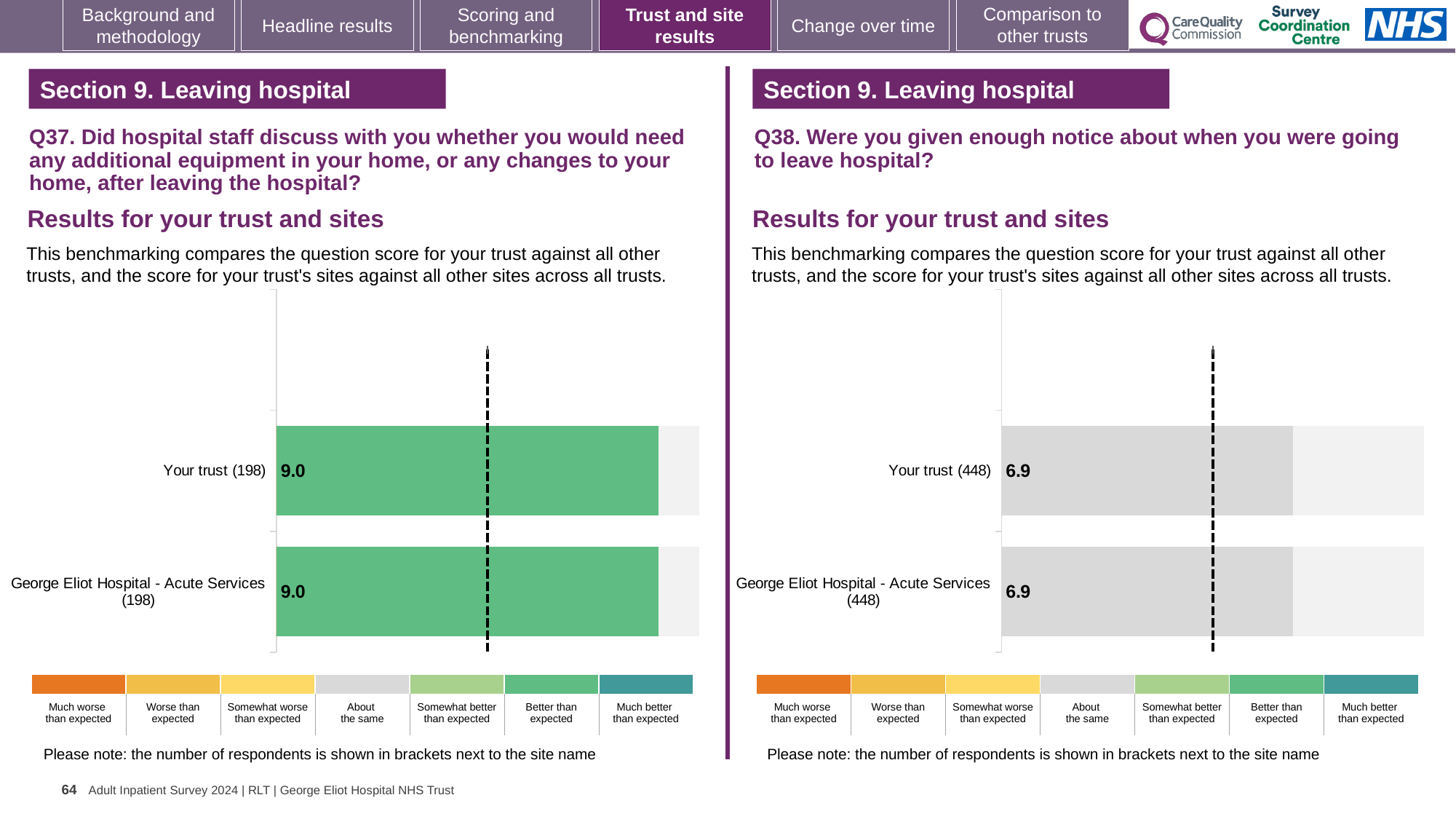
In the Q37 chart on the left, what is the difference between the score for Your trust and the score for George Eliot Hospital - Acute Services? 0.0 In the Q38 chart on the right, what is the score for Your trust? 6.9 According to the colour key, which benchmark category does the green colour of the bars in the Q37 chart on the left represent? Better than expected How many bars are plotted in the Q38 chart on the right? 2 In the Q37 chart on the left, how many respondents are shown in brackets for Your trust? 198 In the Q37 chart on the left, what is the score for George Eliot Hospital - Acute Services? 9.0 In the Q37 chart on the left, what is the score for Your trust? 9.0 In the Q38 chart on the right, what is the score for George Eliot Hospital - Acute Services? 6.9 In the Q38 chart on the right, what is the difference between the score for Your trust and the score for George Eliot Hospital - Acute Services? 0.0 How many bars are plotted in the Q37 chart on the left? 2 What type of chart is used for the Q37 results on the left? Bar chart In the Q38 chart on the right, how many respondents are shown in brackets for George Eliot Hospital - Acute Services? 448